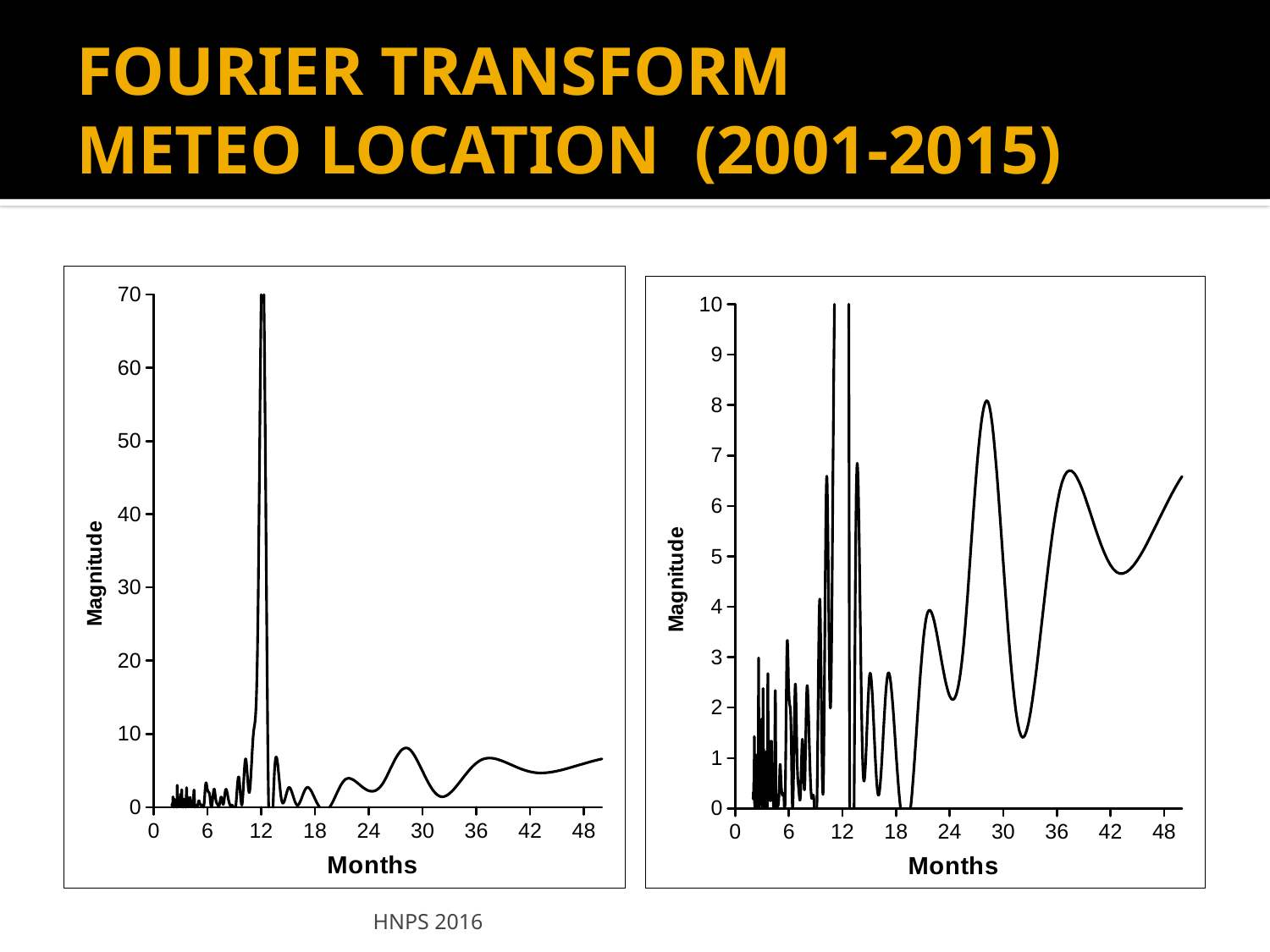
On the left chart, what is the highest value shown on the y axis? 70 What is the label of the y axis on the right chart? Magnitude How many charts are shown on the slide? 2 What kind of chart is the right chart on the slide? line chart On the right chart, is the magnitude at 24 months greater or less than 4? less On the left chart, is the peak magnitude near 12 months greater or less than 60? greater On the left chart, is the magnitude at 30 months greater or less than 20? less On the right chart, what is the highest value shown on the y axis? 10 What kind of chart is the left chart on the slide? line chart On the left chart, is the magnitude higher at 12 months or at 36 months? 12 months